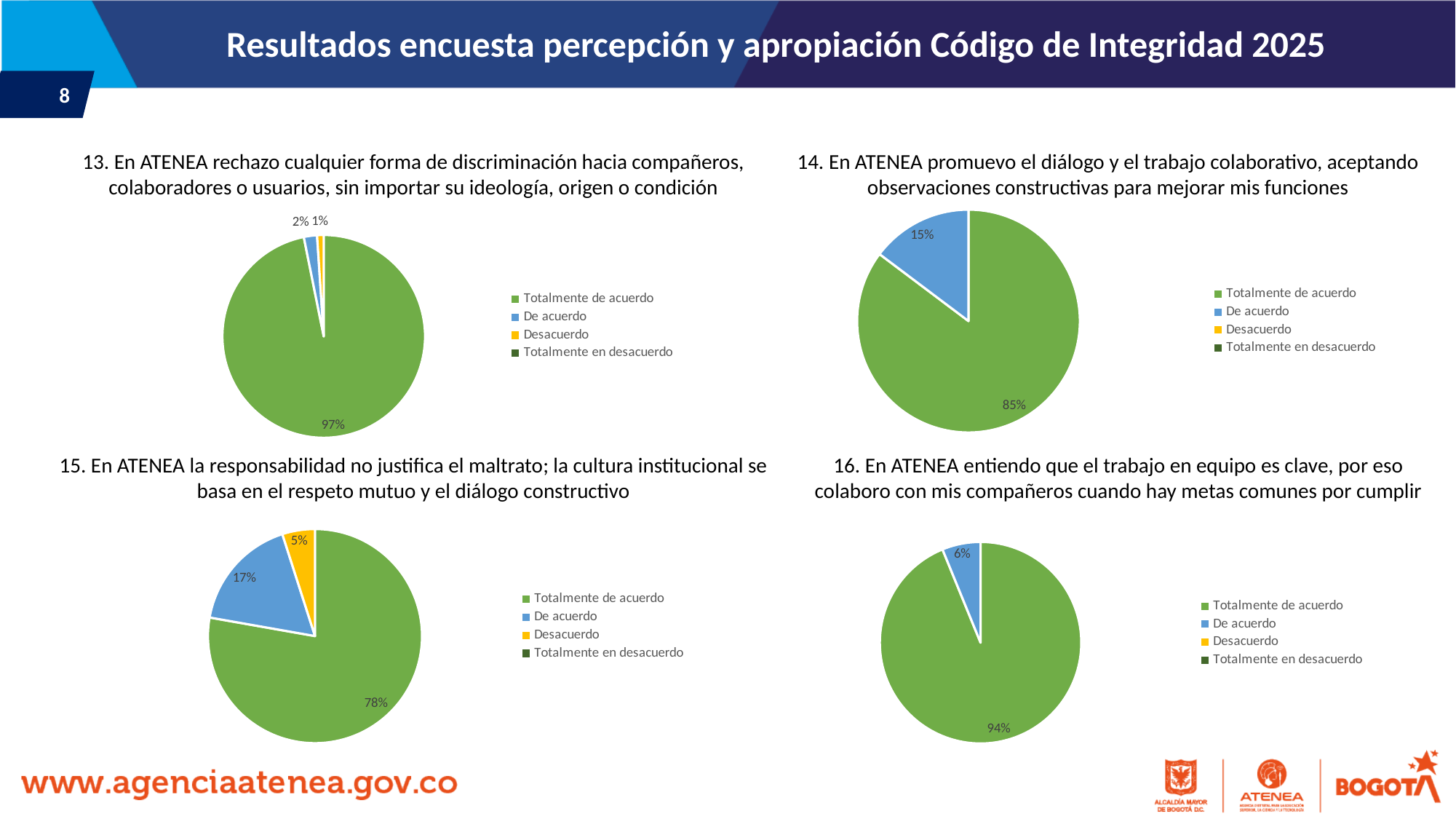
In the top-left pie chart (question 13), what share is labelled for 'Totalmente de acuerdo'? 97% In the bottom-left pie chart (question 15), what percentage is shown for 'Desacuerdo'? 5% In the top-right pie chart (question 14), what is the difference between the 'Totalmente de acuerdo' and 'De acuerdo' shares? 70% In the bottom-right pie chart (question 16), what colour is the 'De acuerdo' slice? Blue In the bottom-right pie chart (question 16), what percentage is shown for 'Totalmente de acuerdo'? 94% How many pie charts are shown on the slide? 4 What type of chart is used for question 16 on the bottom right? Pie chart In the bottom-left pie chart (question 15), which labelled category has the smallest slice? Desacuerdo In the top-right pie chart (question 14), what percentage is shown for 'De acuerdo'? 15% In the bottom-left pie chart (question 15), which category has the largest slice? Totalmente de acuerdo How many entries does the legend of the top-left pie chart (question 13) list? 4 In the bottom-left pie chart (question 15), which is larger: 'De acuerdo' or 'Desacuerdo'? De acuerdo